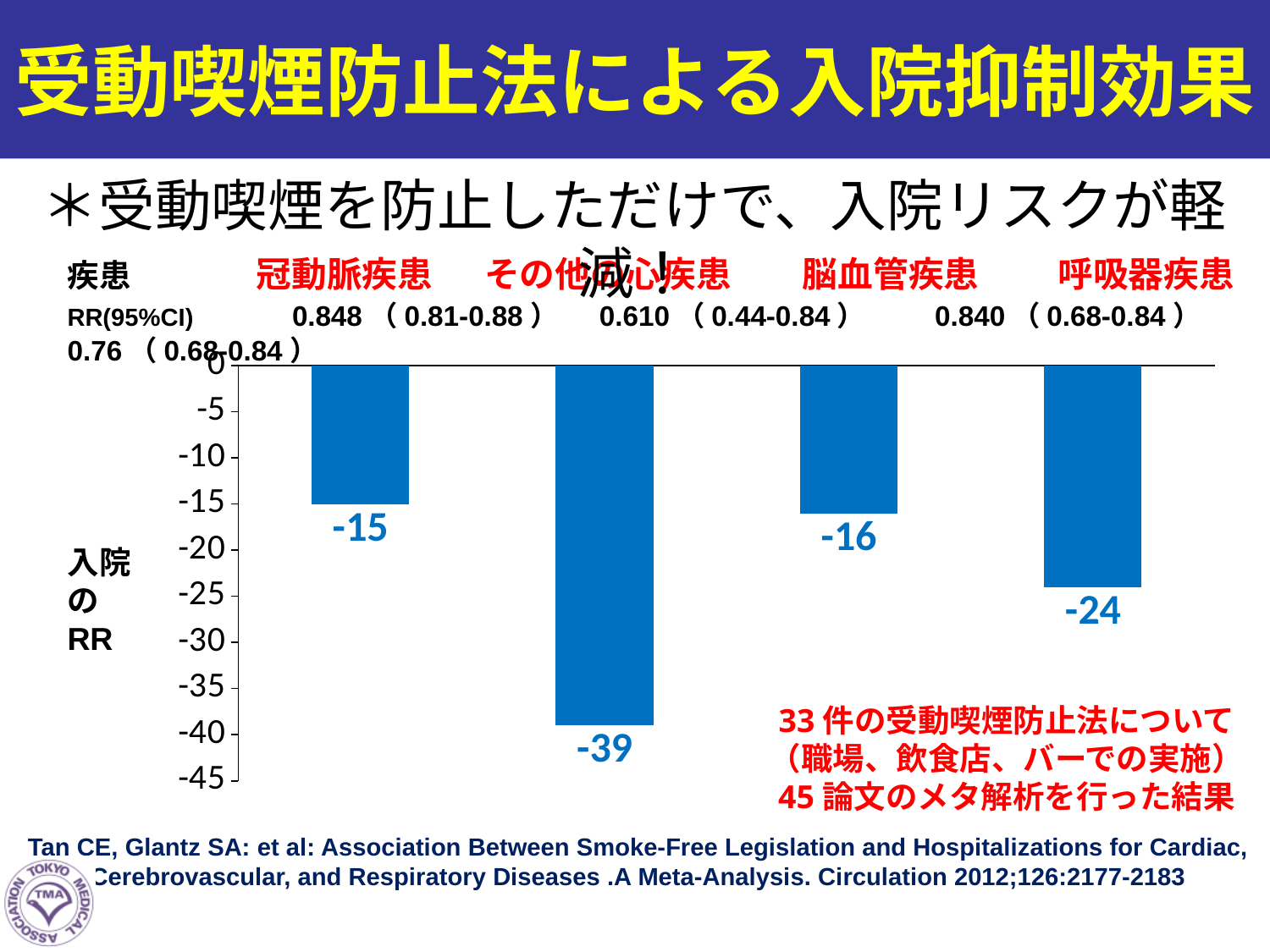
How many bars are plotted in the chart? 4 What is the value shown for 脳血管疾患 in the bar chart? -16 What type of chart is shown on the slide? bar chart What is the value shown for 呼吸器疾患 in the bar chart? -24 What is the lowest value labelled on any bar in the chart? -39 What is the difference between the values for 呼吸器疾患 and 冠動脈疾患? 9 What is the difference between the values for 呼吸器疾患 and 脳血管疾患? 8 Which has the lower value, 脳血管疾患 or 冠動脈疾患? 脳血管疾患 Which category has the highest value (closest to zero) in the bar chart? 冠動脈疾患 Is the value for 呼吸器疾患 greater or less than -20? less What is the value labelled on the second bar from the left in the chart? -39 What is the value shown for 冠動脈疾患 in the bar chart? -15